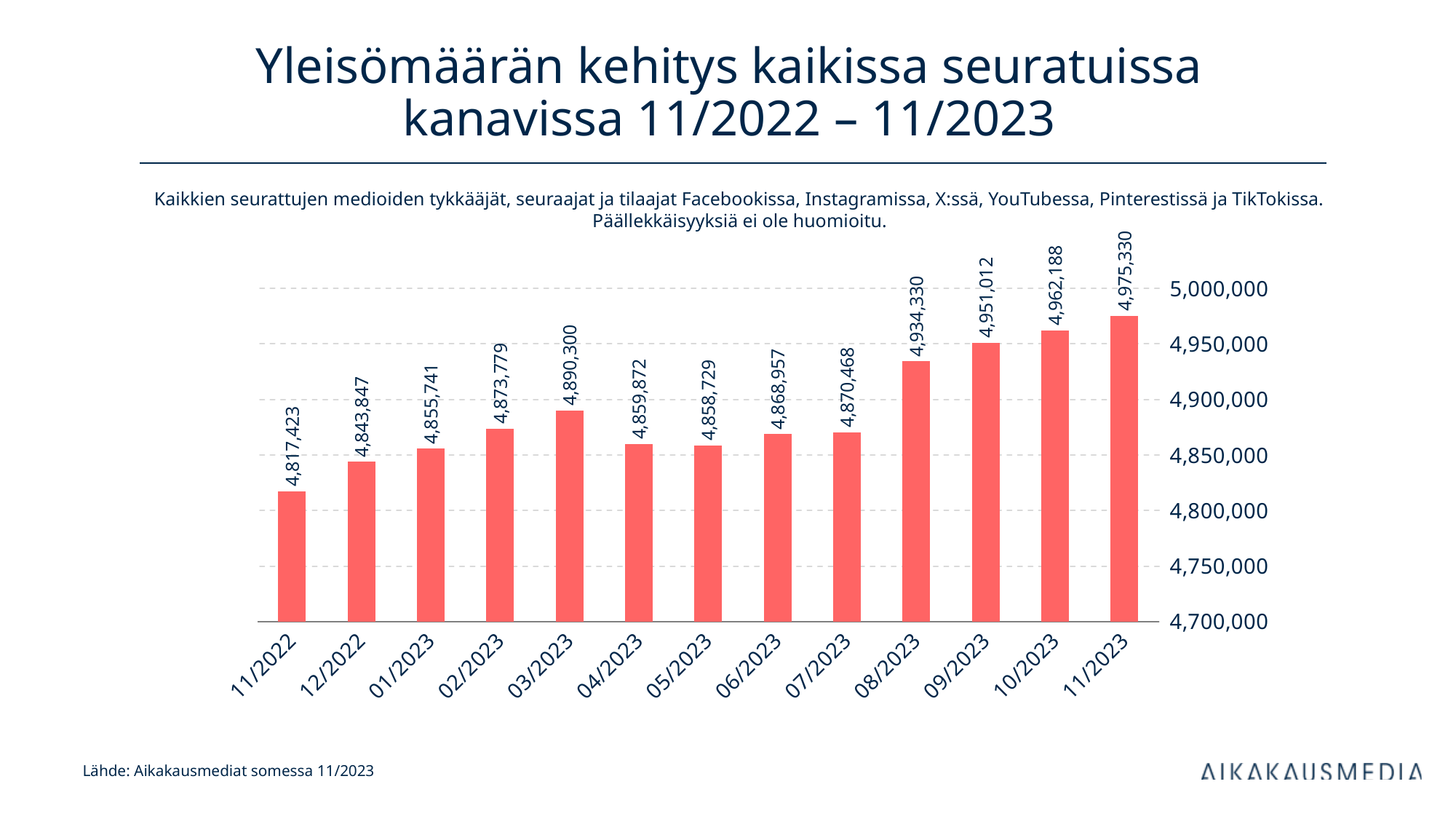
Which month has the highest value? 11/2023 Do the values generally rise or fall from 11/2022 to 11/2023? rise What is the difference between the values for 03/2023 and 04/2023? 30,428 Which is larger, the value for 02/2023 or the value for 07/2023? 02/2023 Is the value for 09/2023 greater or less than 4,900,000? greater What is the value for 08/2023? 4,934,330 Which month has the lowest value? 11/2022 What is the difference between the values for 11/2023 and 11/2022? 157,907 How many months are shown on the x axis? 13 What is the value for 11/2022? 4,817,423 What is the value for 03/2023? 4,890,300 What kind of chart is shown on the slide? bar chart